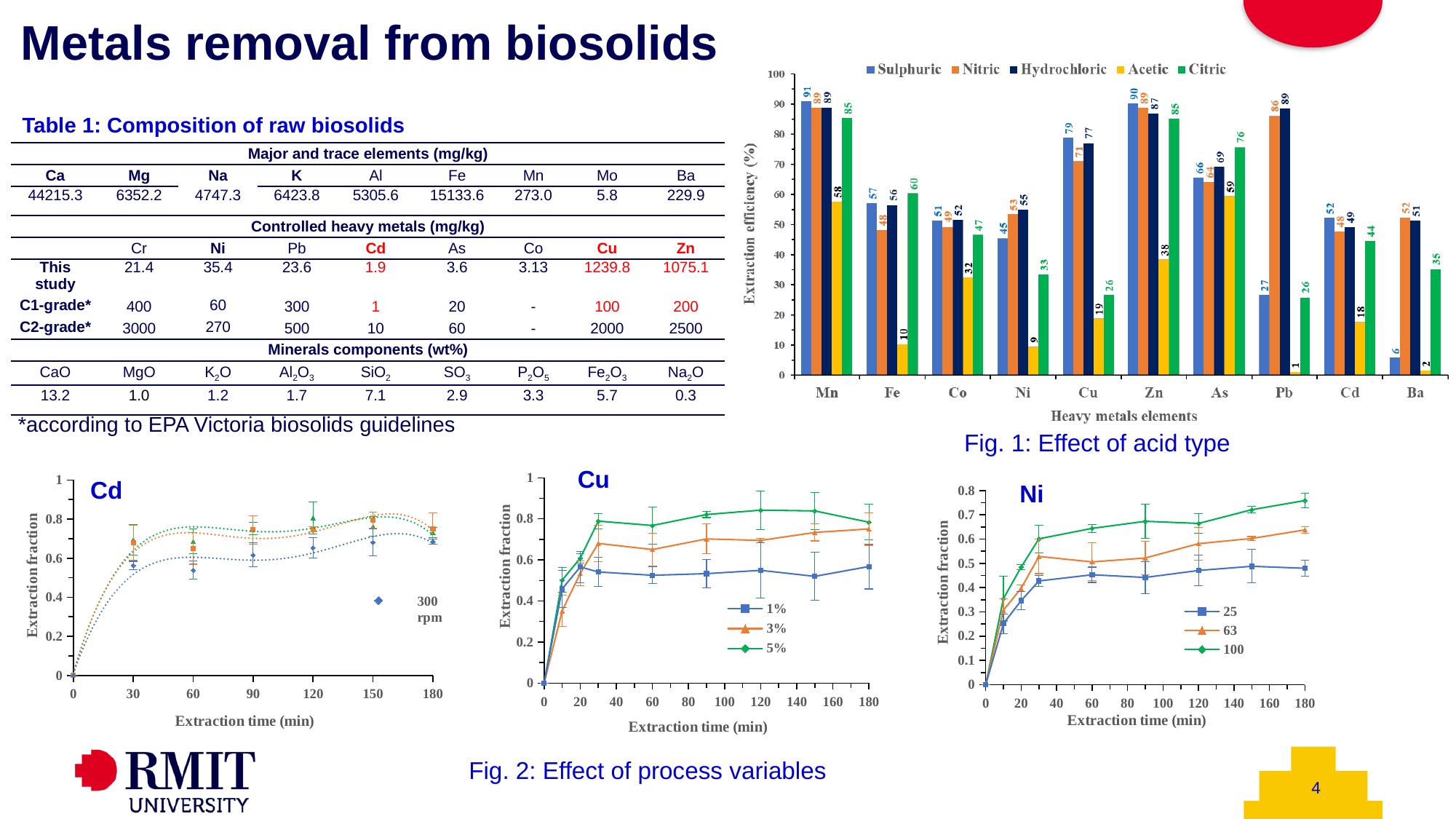
What kind of chart is Fig. 1 (Effect of acid type)? Bar chart In Fig. 1 (Effect of acid type), what is the extraction efficiency of Citric acid for As? 76 In Fig. 1 (Effect of acid type), what is the extraction efficiency of Sulphuric acid for Mn? 91 In the Ni chart of Fig. 2, is the extraction fraction for the 100 series at 180 min greater or less than 0.7? greater In Fig. 1 (Effect of acid type), which acid gives the lowest extraction efficiency for Ba? Acetic In Fig. 1 (Effect of acid type), which is larger for Ni: the Nitric or the Citric extraction efficiency? Nitric In Fig. 1 (Effect of acid type), how many acid types does the legend list? 5 In Fig. 1 (Effect of acid type), what is the extraction efficiency of Acetic acid for Fe? 10 In Fig. 1 (Effect of acid type), how many heavy metal elements are shown on the x axis? 10 In the Cu chart of Fig. 2, how many series does the legend list? 3 In Fig. 1 (Effect of acid type), what is the difference between the Sulphuric and Acetic extraction efficiencies for Cu? 60 In Fig. 1 (Effect of acid type), which acid gives the highest extraction efficiency for Pb? Hydrochloric